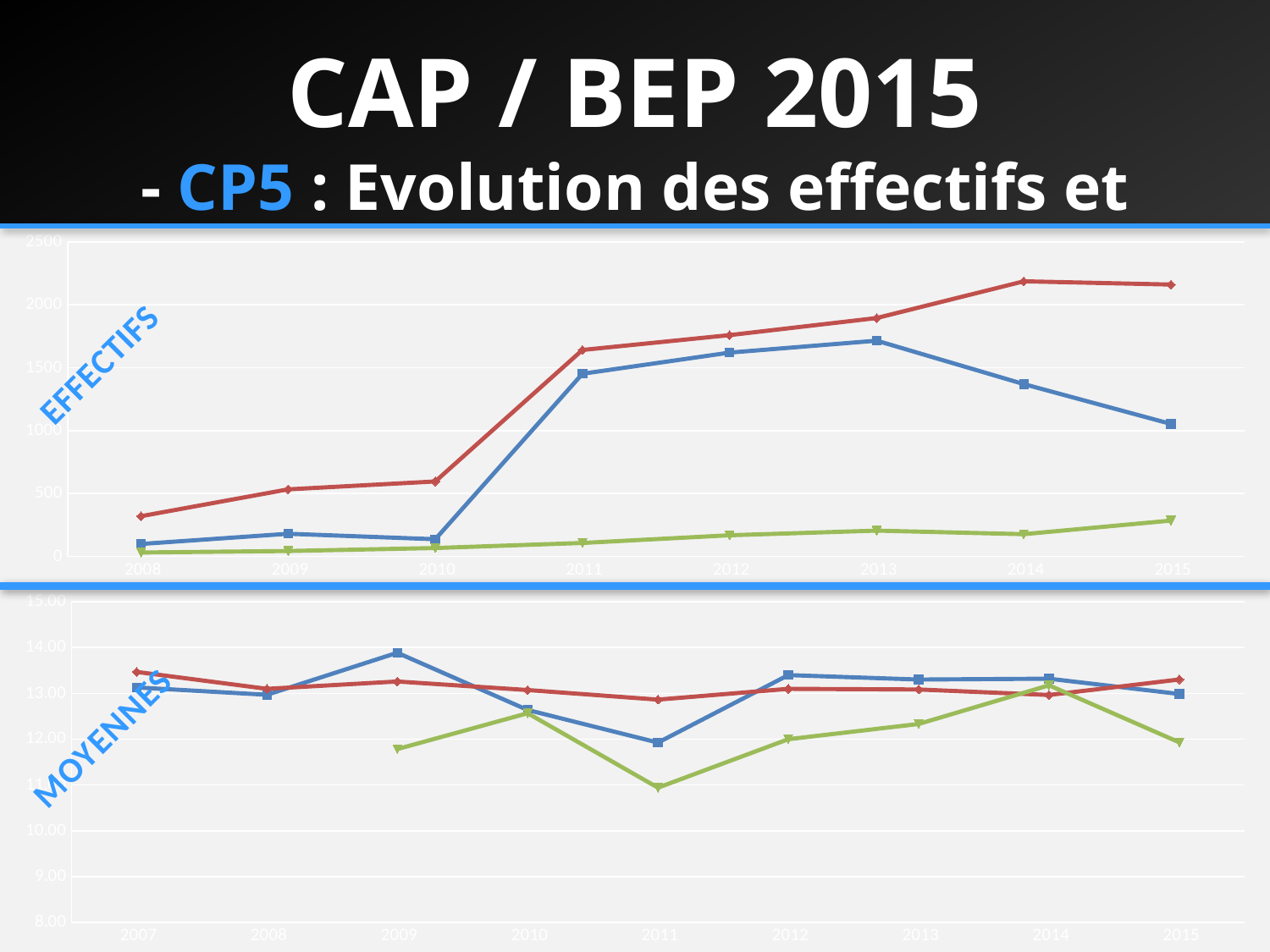
In the top chart (EFFECTIFS), is the value of the green line in 2015 greater or less than 500? less In the bottom chart (MOYENNES), in which year does the green line reach its lowest value? 2011 In the top chart (EFFECTIFS), how many years are shown on the x axis? 8 In the bottom chart (MOYENNES), how many years are shown on the x axis? 9 In the top chart (EFFECTIFS), is the value of the blue line in 2015 greater or less than 1500? less In the bottom chart (MOYENNES), is the value of the green line in 2011 greater or less than 12.00? less What kind of chart is the top chart labelled EFFECTIFS? line chart In the bottom chart (MOYENNES), in which year does the blue line reach its highest value? 2009 In the top chart (EFFECTIFS), in which year does the blue line reach its highest value? 2013 In the top chart (EFFECTIFS), which line is higher in 2011, the red line or the blue line? red line In the top chart (EFFECTIFS), does the blue line rise or fall from 2013 to 2015? fall